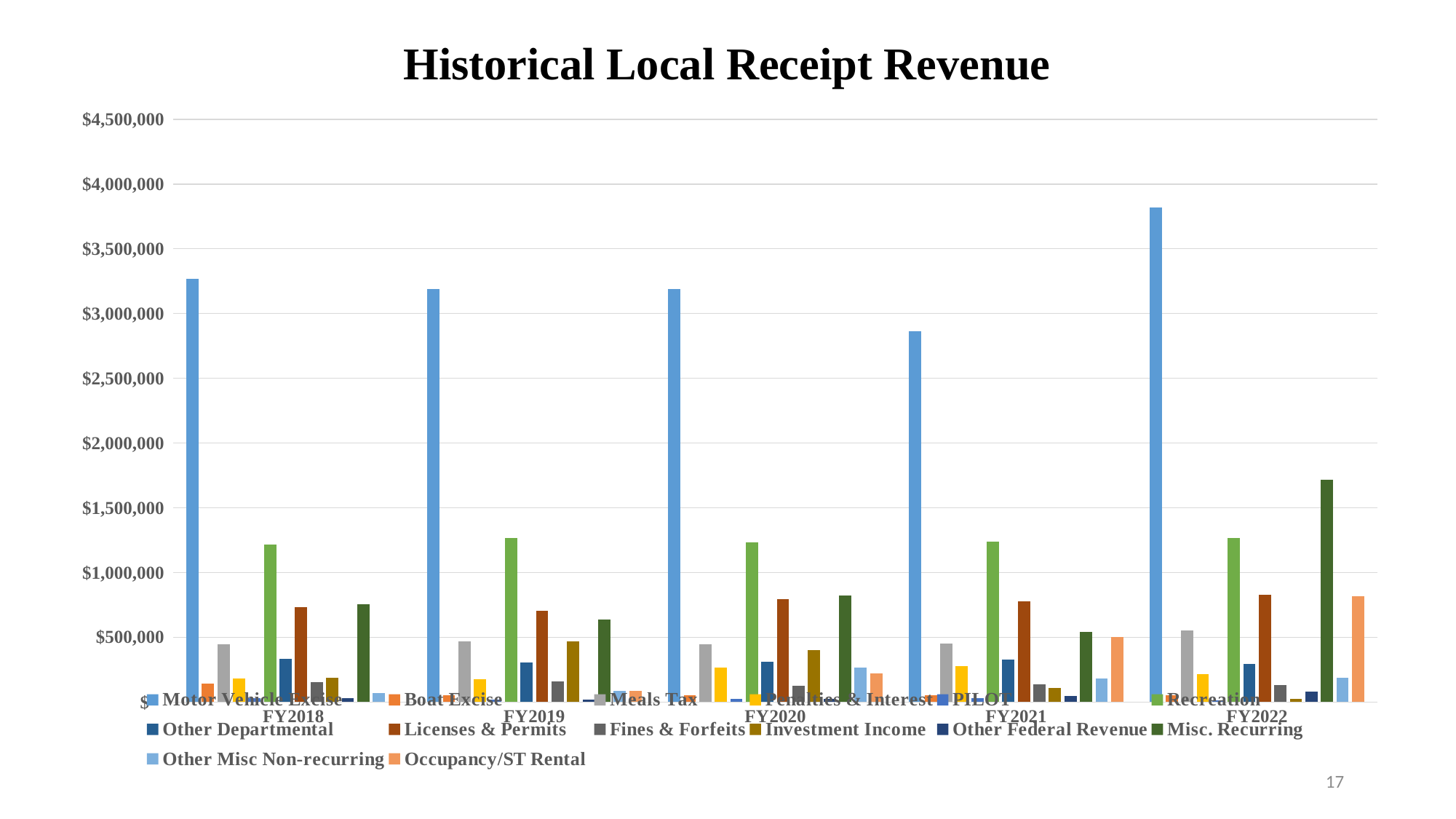
How many fiscal years are shown on the x axis? 5 Which series has the tallest bar in every fiscal year? Motor Vehicle Excise What is the title of the chart? Historical Local Receipt Revenue Is the value for Motor Vehicle Excise in FY2021 greater or less than $3,000,000? less What kind of chart is shown on the slide? bar chart Which is larger in FY2022: Misc. Recurring or Recreation? Misc. Recurring Is the value for Recreation in FY2018 greater or less than $1,000,000? greater Is the value for Misc. Recurring in FY2022 greater or less than $1,500,000? greater How many series does the legend list? 14 In which fiscal year is the Motor Vehicle Excise bar the highest? FY2022 Which is larger for Motor Vehicle Excise: FY2021 or FY2022? FY2022